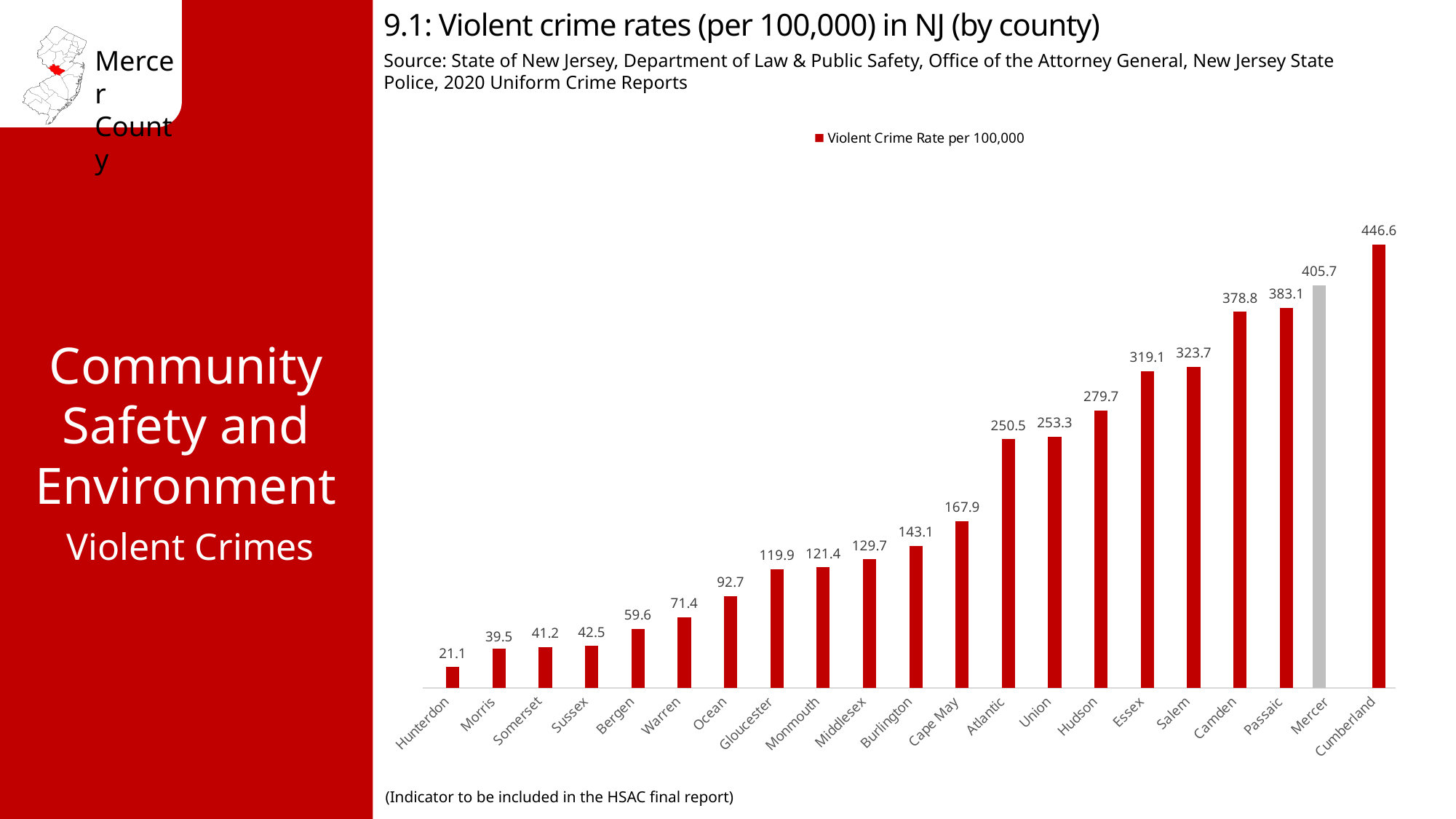
Which county has the lowest violent crime rate? Hunterdon Which county has the highest violent crime rate? Cumberland What is the violent crime rate per 100,000 for Hudson County? 279.7 What is the violent crime rate per 100,000 for Cape May? 167.9 Which county has a higher violent crime rate, Essex or Camden? Camden What is the violent crime rate per 100,000 for Mercer County? 405.7 How many series does the legend list? 1 What kind of chart is shown on the slide? Bar chart How many counties are shown on the chart? 21 What is the difference between the violent crime rates of Mercer and Hunterdon? 384.6 Do the values rise or fall from left to right along the x axis? Rise What is the difference between the violent crime rates of Cumberland and Mercer? 40.9